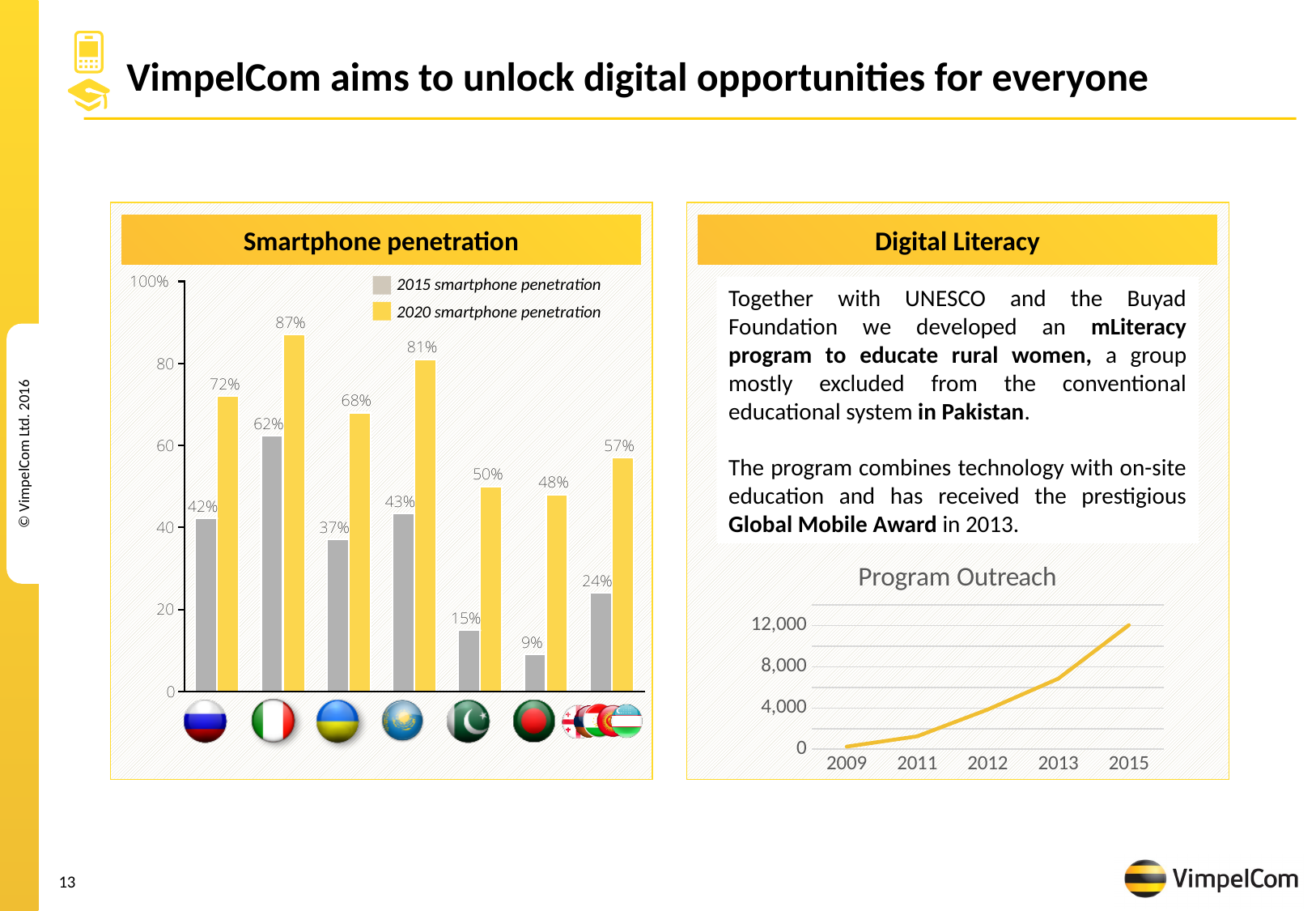
On the Program Outreach chart, is the value for 2013 greater or less than 4,000? greater On the Smartphone penetration chart, which category has the lowest 2015 smartphone penetration? The sixth category from the left (9%) How many series does the legend of the Smartphone penetration chart list? 2 On the Smartphone penetration chart, what is the 2015 smartphone penetration for the leftmost category? 42% On the Smartphone penetration chart, what is the difference between the 2020 and 2015 smartphone penetration for the fourth category from the left? 38% What kind of chart is the Program Outreach chart? Line chart How many categories are shown on the Smartphone penetration chart? 7 On the Smartphone penetration chart, what is the 2020 smartphone penetration for the second category from the left? 87% On the Smartphone penetration chart, which is larger: the 2015 penetration of the leftmost category or the 2015 penetration of the fourth category from the left? The fourth category (43%) On the Program Outreach chart, do the values rise or fall from 2009 to 2015? Rise What kind of chart is the Smartphone penetration chart? Bar chart On the Smartphone penetration chart, what is the highest 2020 smartphone penetration value shown? 87%